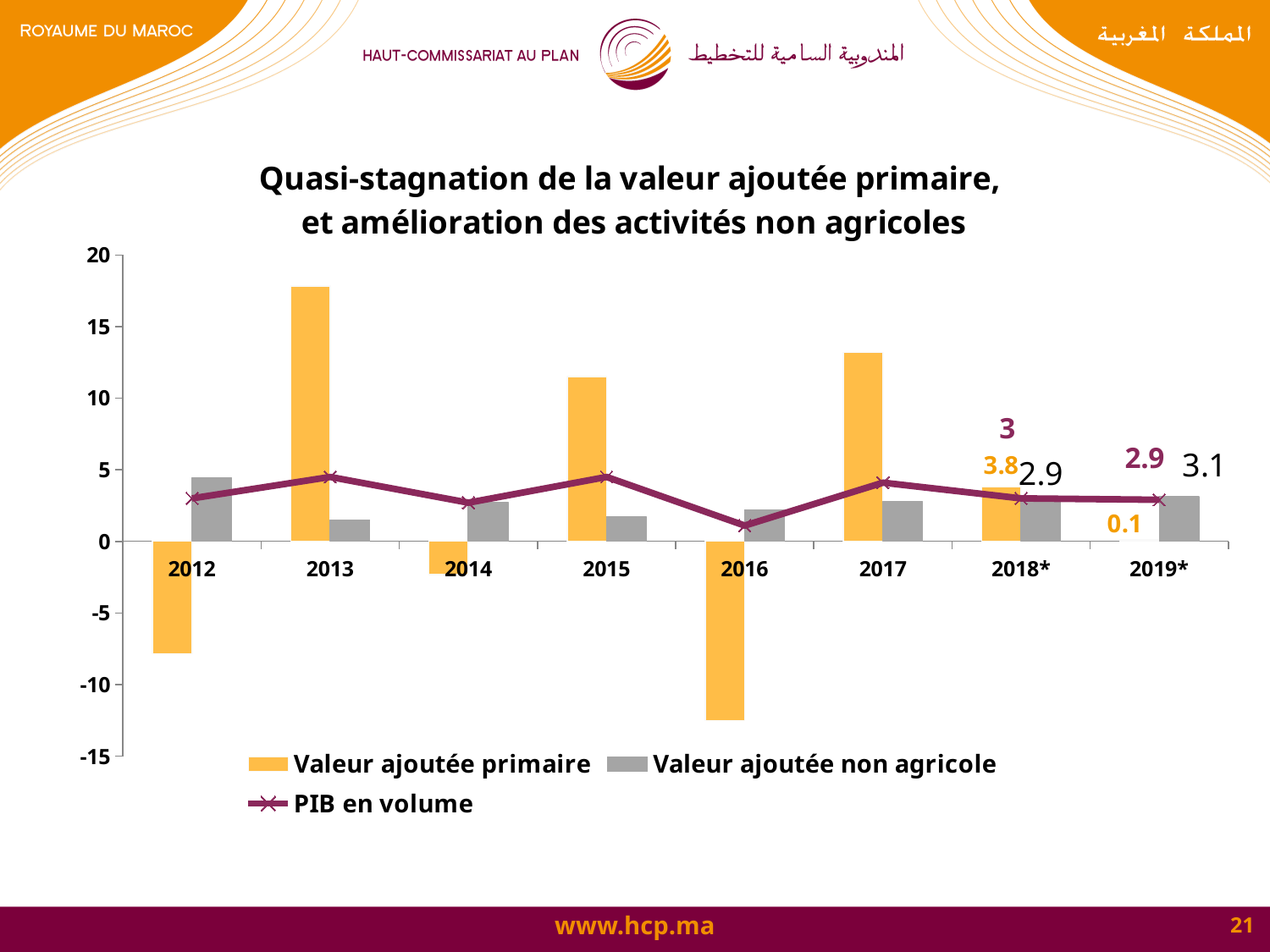
In which year is the Valeur ajoutée primaire bar the lowest? 2016 How many years are shown on the x axis? 8 In 2018*, which is larger: Valeur ajoutée primaire or Valeur ajoutée non agricole? Valeur ajoutée primaire How many series does the legend list? 3 What is the value of PIB en volume for 2018*? 3 What is the value of Valeur ajoutée primaire for 2018*? 3.8 What is the value of PIB en volume for 2019*? 2.9 Is the value for Valeur ajoutée primaire in 2013 greater or less than 15? greater What is the difference between Valeur ajoutée primaire in 2018* and in 2019*? 3.7 What is the value of Valeur ajoutée non agricole for 2019*? 3.1 What is the value of Valeur ajoutée primaire for 2019*? 0.1 In which year is the Valeur ajoutée primaire bar the highest? 2013